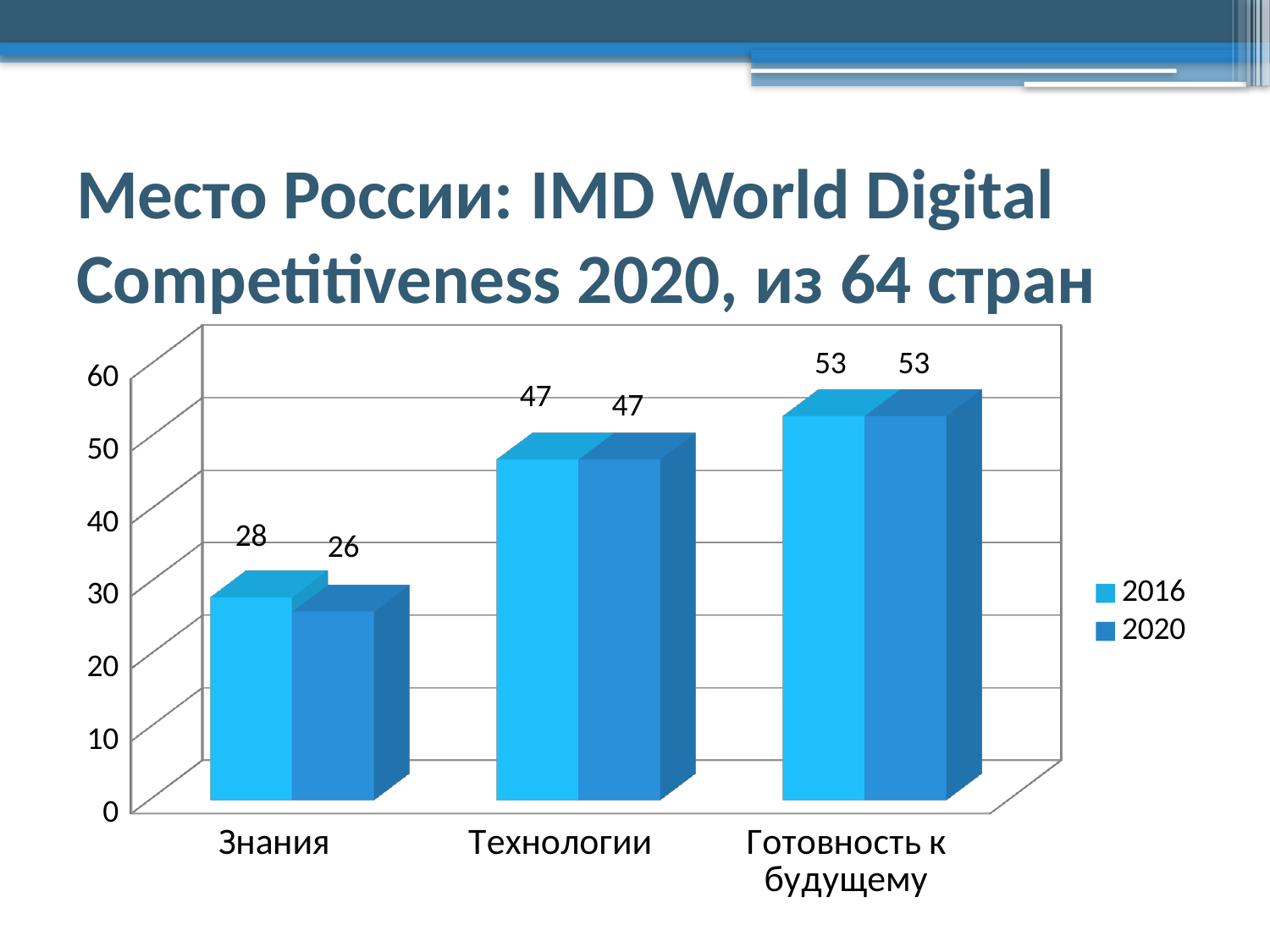
Which category has the highest value in the 2020 series? Готовность к будущему How many series does the legend list? 2 What is the value for Знания in 2016? 28 What is the difference between the 2016 and 2020 values for Знания? 2 What is the value for Знания in 2020? 26 How many categories are shown on the x axis? 3 What is the value for Готовность к будущему in 2016? 53 What is the value for Технологии in 2020? 47 What kind of chart is shown on the slide? Bar chart Which category has the lowest value in the 2016 series? Знания What is the difference between the 2016 values for Готовность к будущему and Знания? 25 Which is larger: the 2016 value for Технологии or the 2016 value for Знания? Технологии